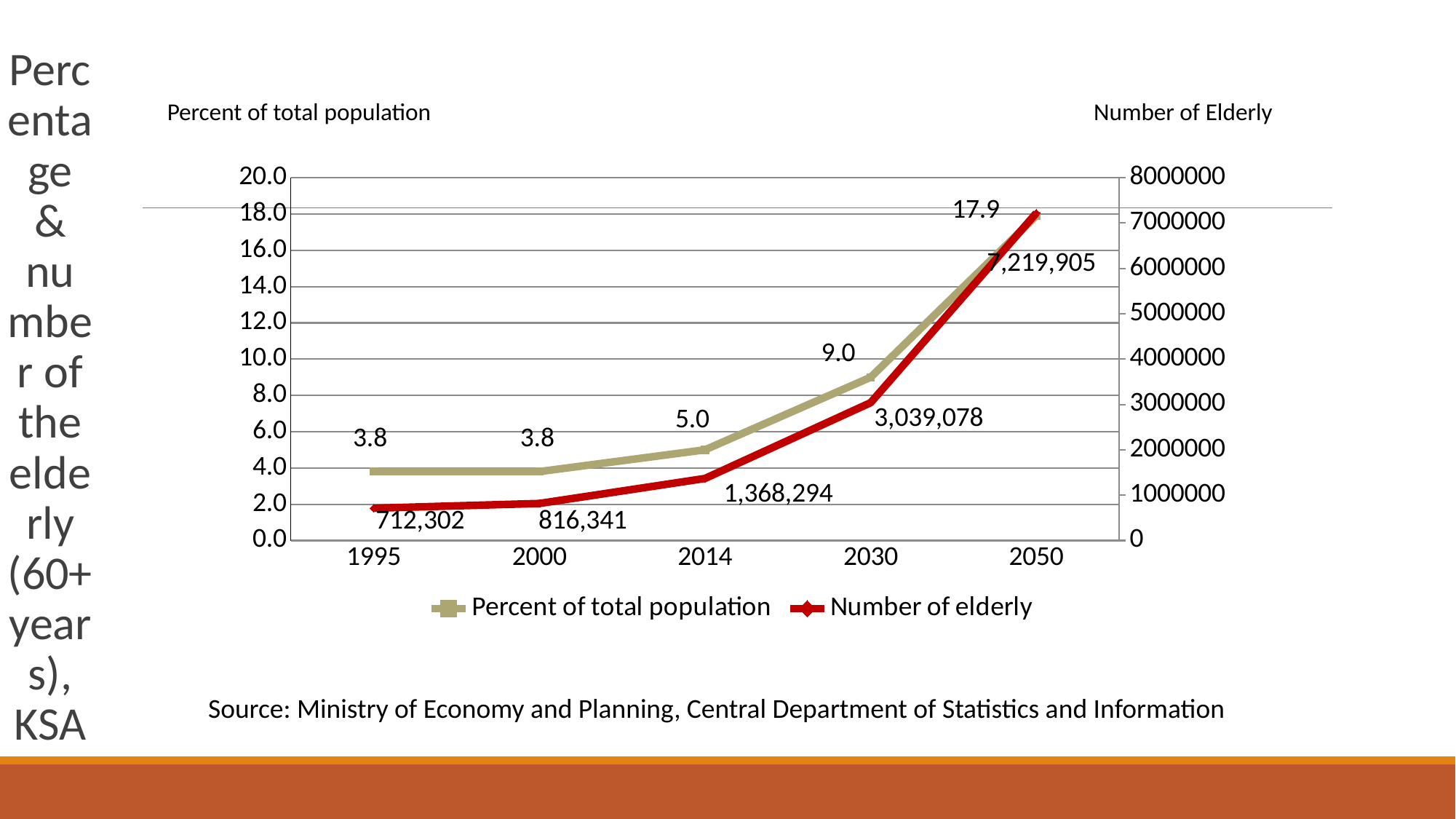
How many series does the legend list? 2 What is the number of elderly in 2030? 3,039,078 What is the difference in the number of elderly between 2050 and 2030? 4,180,827 Which year has the highest number of elderly? 2050 What kind of chart is shown on the slide? Line chart What is the percent of total population value for 2050? 17.9 What is the difference in percent of total population between 2030 and 2014? 4.0 Which is larger, the number of elderly in 2000 or in 2014? 2014 What is the number of elderly in 1995? 712,302 How many years are plotted on the x axis? 5 What is the percent of total population value for 2014? 5.0 Which year has the lowest number of elderly? 1995